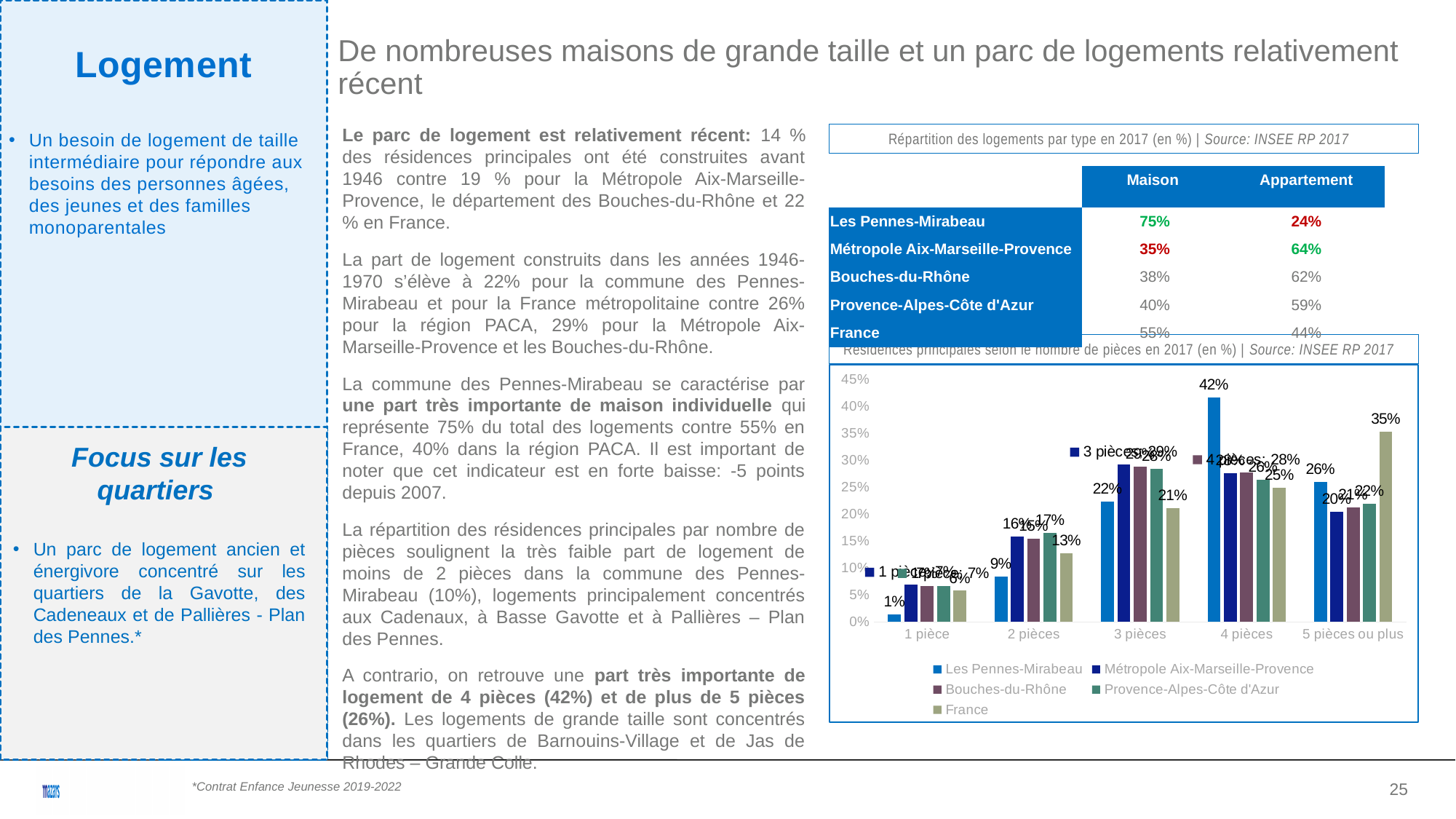
What is the value for Les Pennes-Mirabeau in the '4 pièces' category? 42% In the '5 pièces ou plus' category, which is larger: Les Pennes-Mirabeau or France? France What kind of chart is shown on the slide? bar chart What is the value for Les Pennes-Mirabeau in the '1 pièce' category? 1% What is the value for France in the '2 pièces' category? 13% In which category does Les Pennes-Mirabeau reach its highest value? 4 pièces Is the value for Métropole Aix-Marseille-Provence in the '4 pièces' category greater or less than 20%? greater How many categories are shown on the x axis of the chart? 5 How many series does the legend of the chart list? 5 What is the value for France in the '5 pièces ou plus' category? 35% What is the difference between the Les Pennes-Mirabeau value and the France value in the '4 pièces' category? 17% What is the value for Les Pennes-Mirabeau in the '5 pièces ou plus' category? 26%